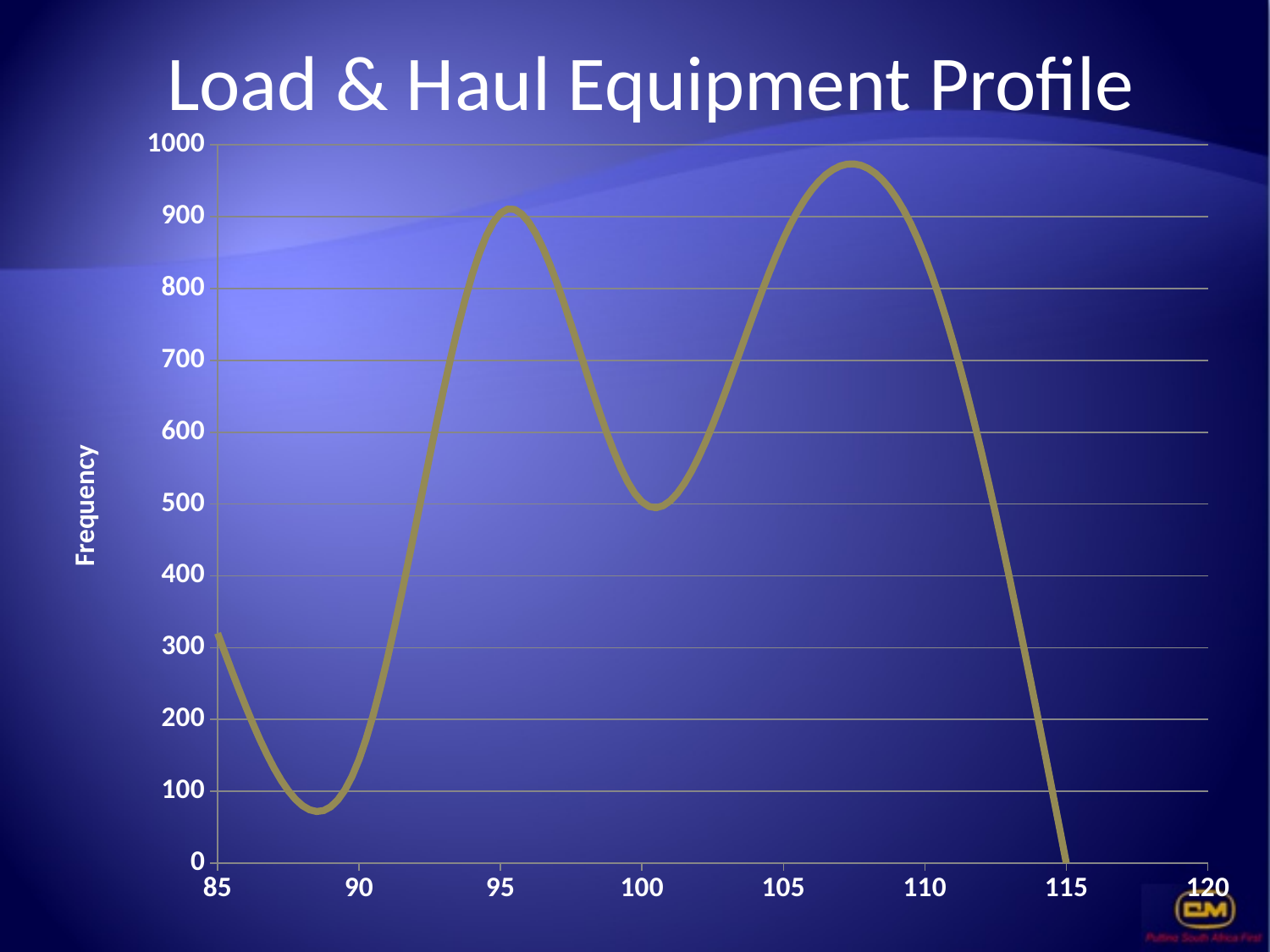
Does the line rise or fall between 110 and 115? fall Is the value at 100 greater or less than 600? less Is the value at 85 greater or less than 200? greater What is the title of the chart? Load & Haul Equipment Profile Is the value at 95 greater or less than 800? greater Does the line rise or fall between 90 and 95? rise Which of the two peaks is higher, the one near 95 or the one near 107? the one near 107 What kind of chart is shown on the slide? line chart What value does the line reach at 115? 0 What is the label on the vertical axis? Frequency